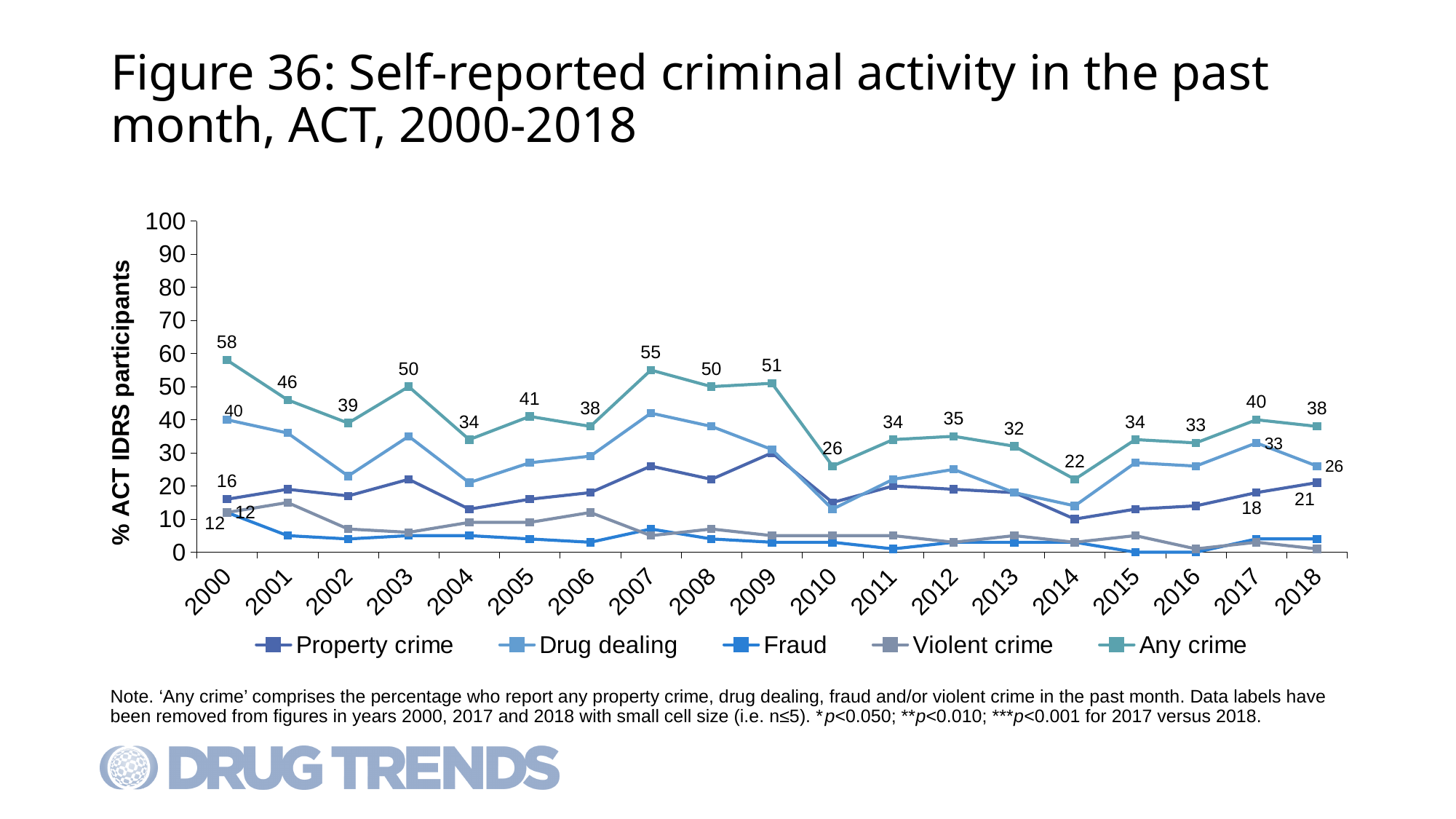
What is the value for Property crime in 2017? 18 What is the difference between the Any crime values for 2017 and 2018? 2 How many years are plotted on the x axis? 19 Which year has the higher Any crime value, 2007 or 2009? 2007 In which year is the Any crime series at its highest? 2000 In which year is the Any crime series at its lowest? 2014 What kind of chart is shown on the slide? Line chart What is the value for Any crime in 2000? 58 What is the value for Drug dealing in 2018? 26 Is the value for Property crime in 2009 greater or less than 20? greater How many series does the legend list? 5 Does the Any crime series rise or fall from 2000 to 2002? Fall